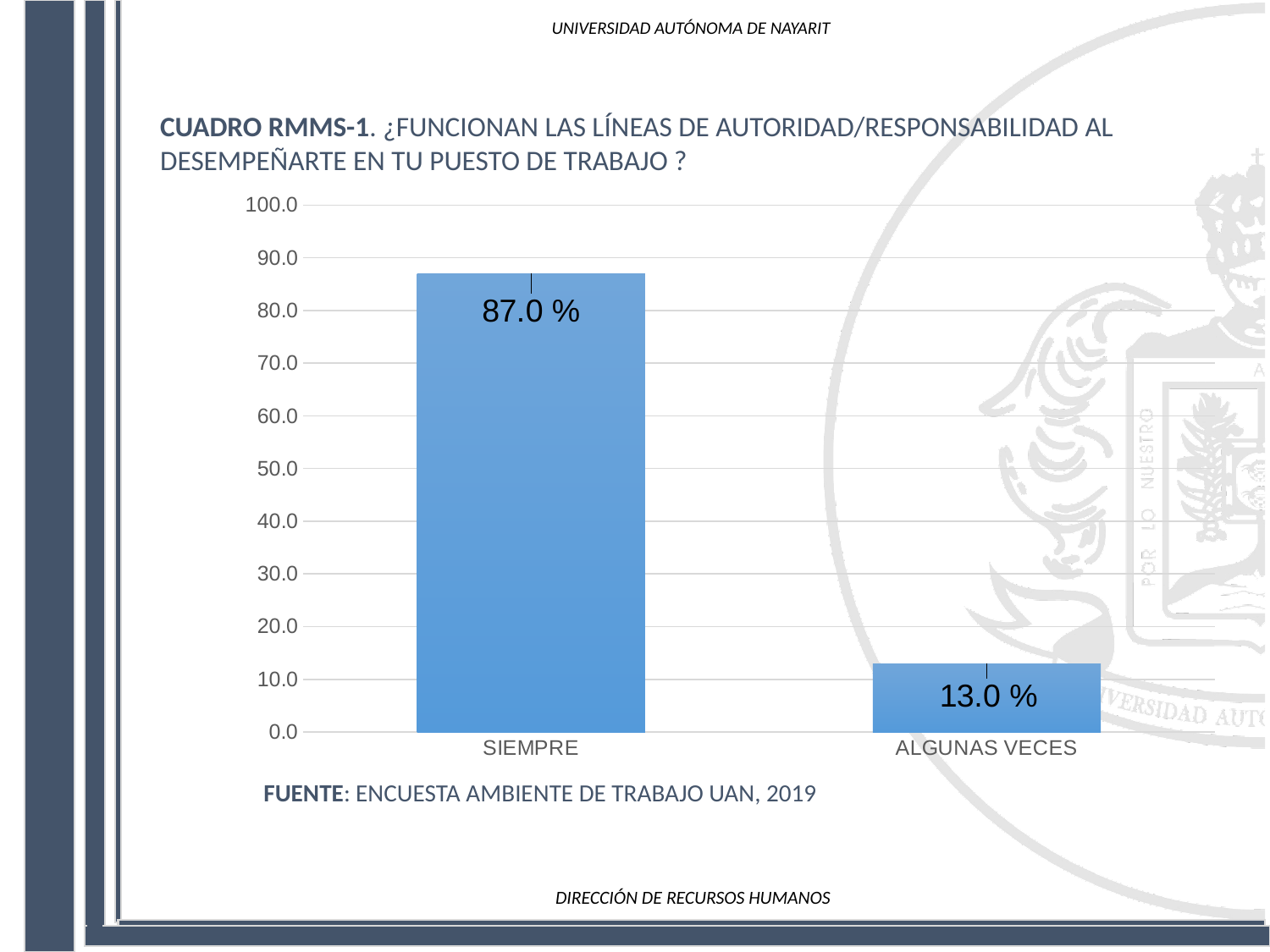
What is the source cited below the chart? ENCUESTA AMBIENTE DE TRABAJO UAN, 2019 What is the difference between the values for SIEMPRE and ALGUNAS VECES? 74.0 % Which is larger, the value for SIEMPRE or the value for ALGUNAS VECES? SIEMPRE Is the value for ALGUNAS VECES greater or less than 20.0? less What is the value for ALGUNAS VECES? 13.0 % Do the values rise or fall from SIEMPRE to ALGUNAS VECES? fall Which category has the lowest value? ALGUNAS VECES What kind of chart is shown on the slide? bar chart Is the value for SIEMPRE greater or less than 80.0? greater How many categories are shown on the x axis? 2 What is the value for SIEMPRE? 87.0 % Which category has the highest value? SIEMPRE